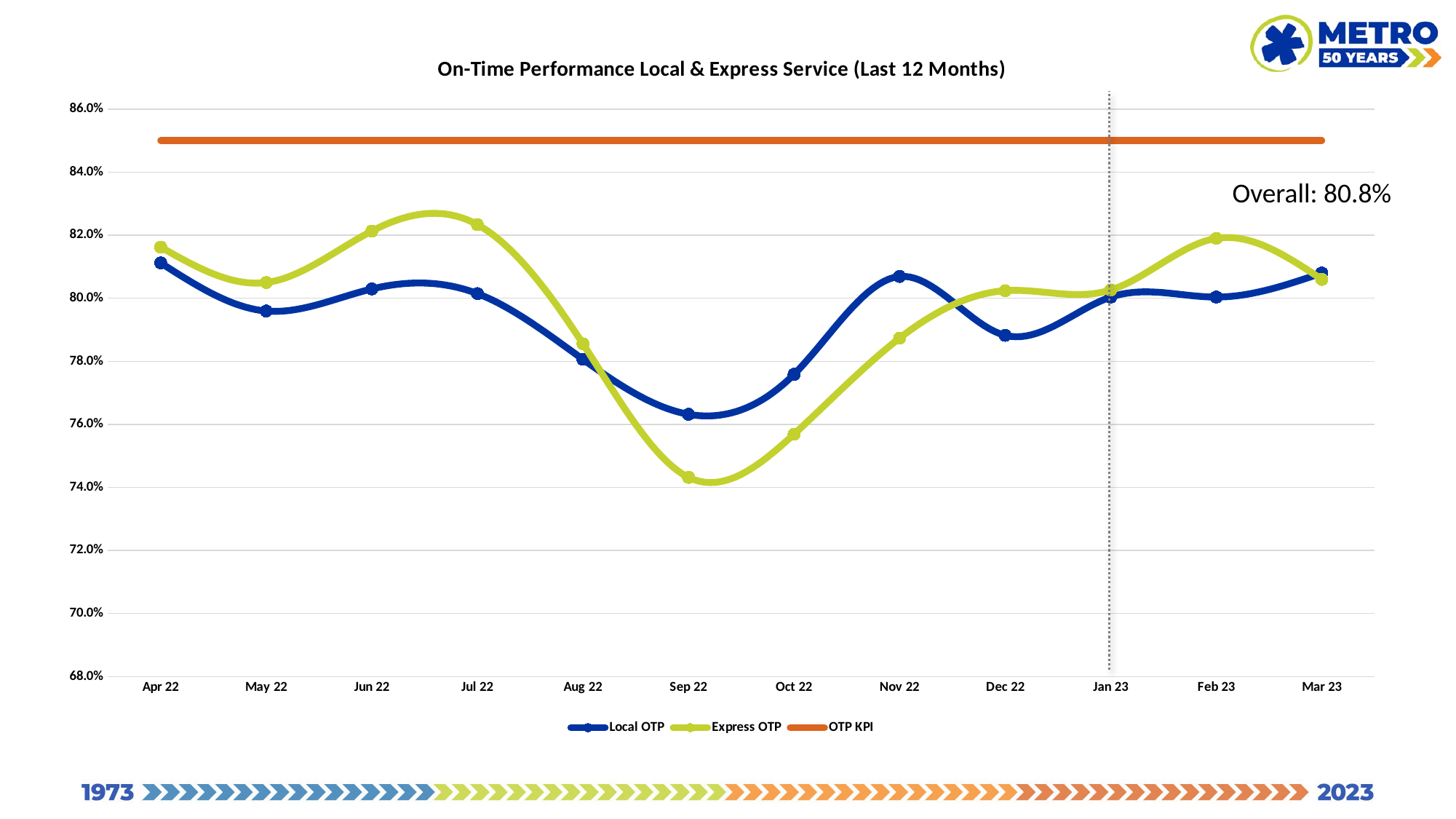
How many series does the legend list? 3 In Jul 22, which is higher: Local OTP or Express OTP? Express OTP What overall on-time performance value is printed on the chart? 80.8% In which month is Local OTP at its lowest? Sep 22 Does Express OTP rise or fall from Jul 22 to Sep 22? fall What kind of chart is shown on the slide? line chart Is the Express OTP value for Jun 22 greater or less than 80.0%? greater Is the Express OTP value for Sep 22 greater or less than 76.0%? less Is the Local OTP value for Sep 22 greater or less than 78.0%? less In Sep 22, which is higher: Local OTP or Express OTP? Local OTP How many months are plotted along the x axis? 12 In which month is Express OTP at its lowest? Sep 22